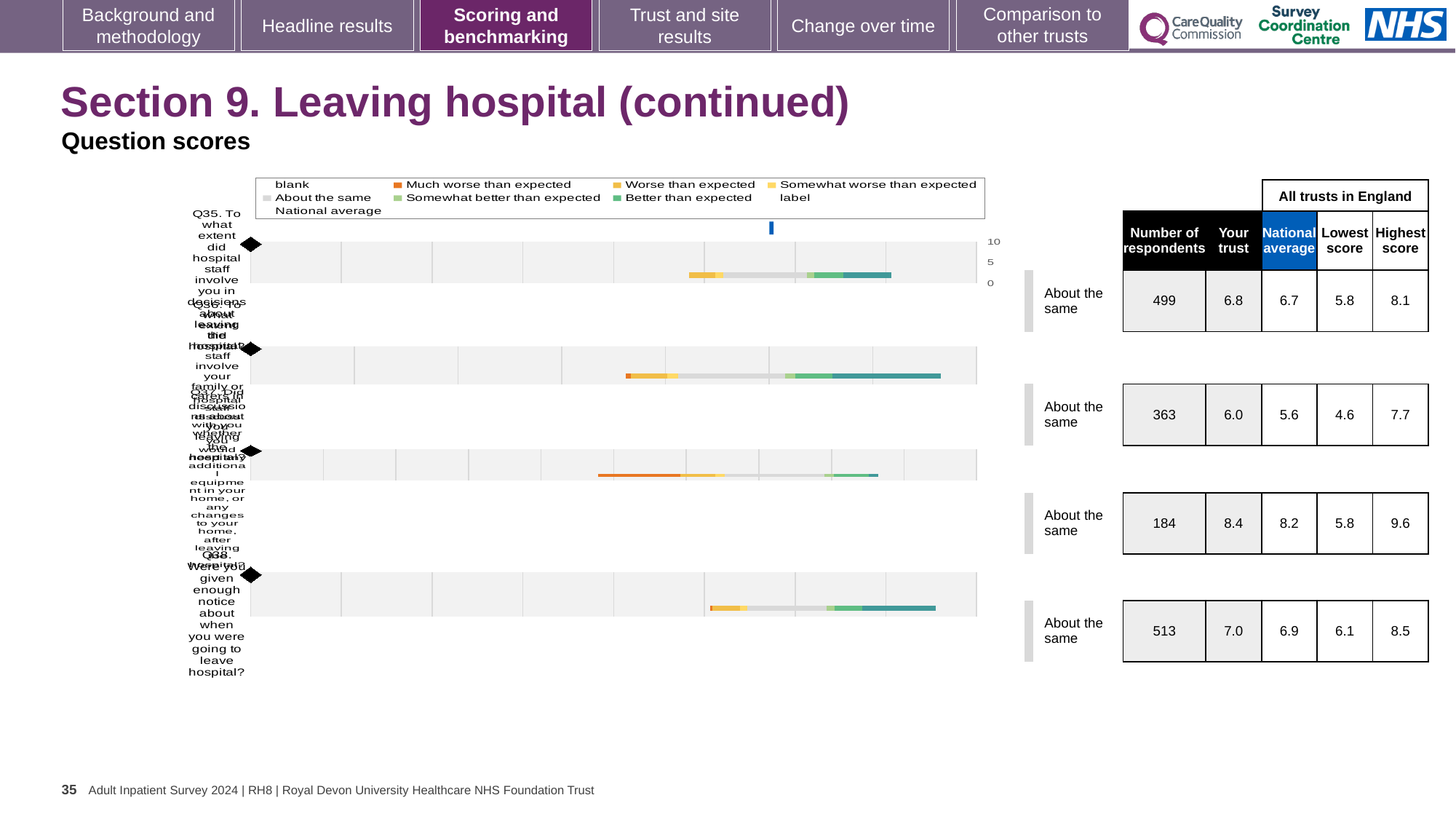
For Q35, is the 'Your trust' score or the national average score larger? Your trust How many respondents answered Q38 (given enough notice about leaving hospital)? 513 What is the difference between the 'Your trust' score and the national average for Q35? 0.1 What benchmark category is shown for every question row in the chart? About the same Which question row has the highest number of respondents? Q38 For Q38, what is the difference between the highest score and the lowest score across all trusts in England? 2.4 What is the 'Your trust' score for Q35 (involving you in decisions about leaving hospital)? 6.8 What is the national average score for Q35? 6.7 How many question rows are plotted in the chart? 4 What is the highest score across all trusts in England for Q38? 8.5 What is the lowest number of respondents shown for any question row? 184 What kind of chart is shown on the slide? bar chart